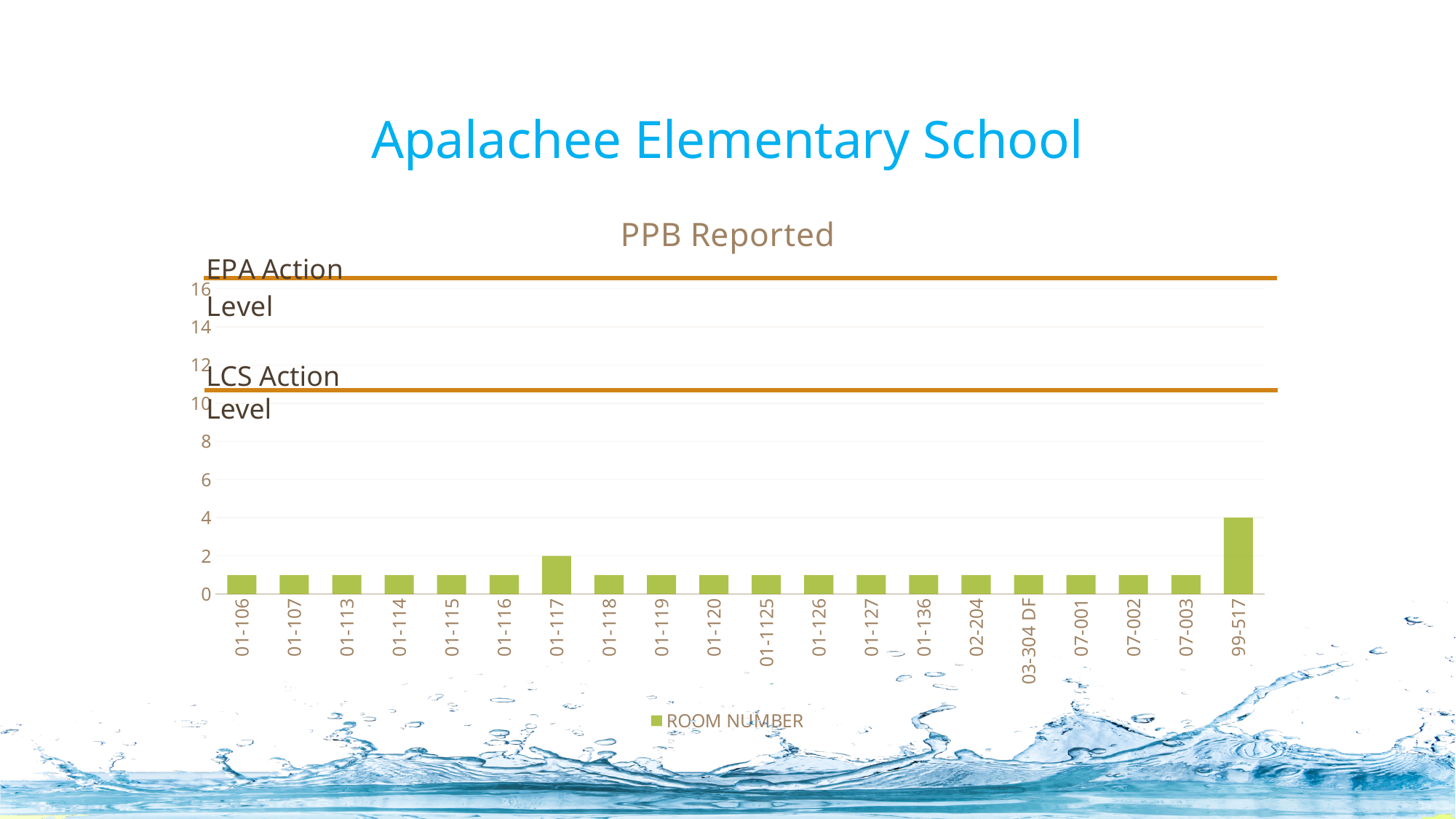
How many room number categories are plotted on the x axis? 20 Is the value for room 99-517 greater or less than 10? less What is the PPB reported value for room 01-117? 2 Which room has the highest PPB reported value? 99-517 How many series does the legend list? 1 What is the difference between the values for room 99-517 and room 01-117? 2 What is the title of the chart? PPB Reported What is the PPB reported value for room 99-517? 4 Is the value for room 01-106 greater or less than 2? less Which has a larger value, room 99-517 or room 01-117? 99-517 What type of chart is shown on the slide? bar chart What is the legend entry for the plotted series? ROOM NUMBER